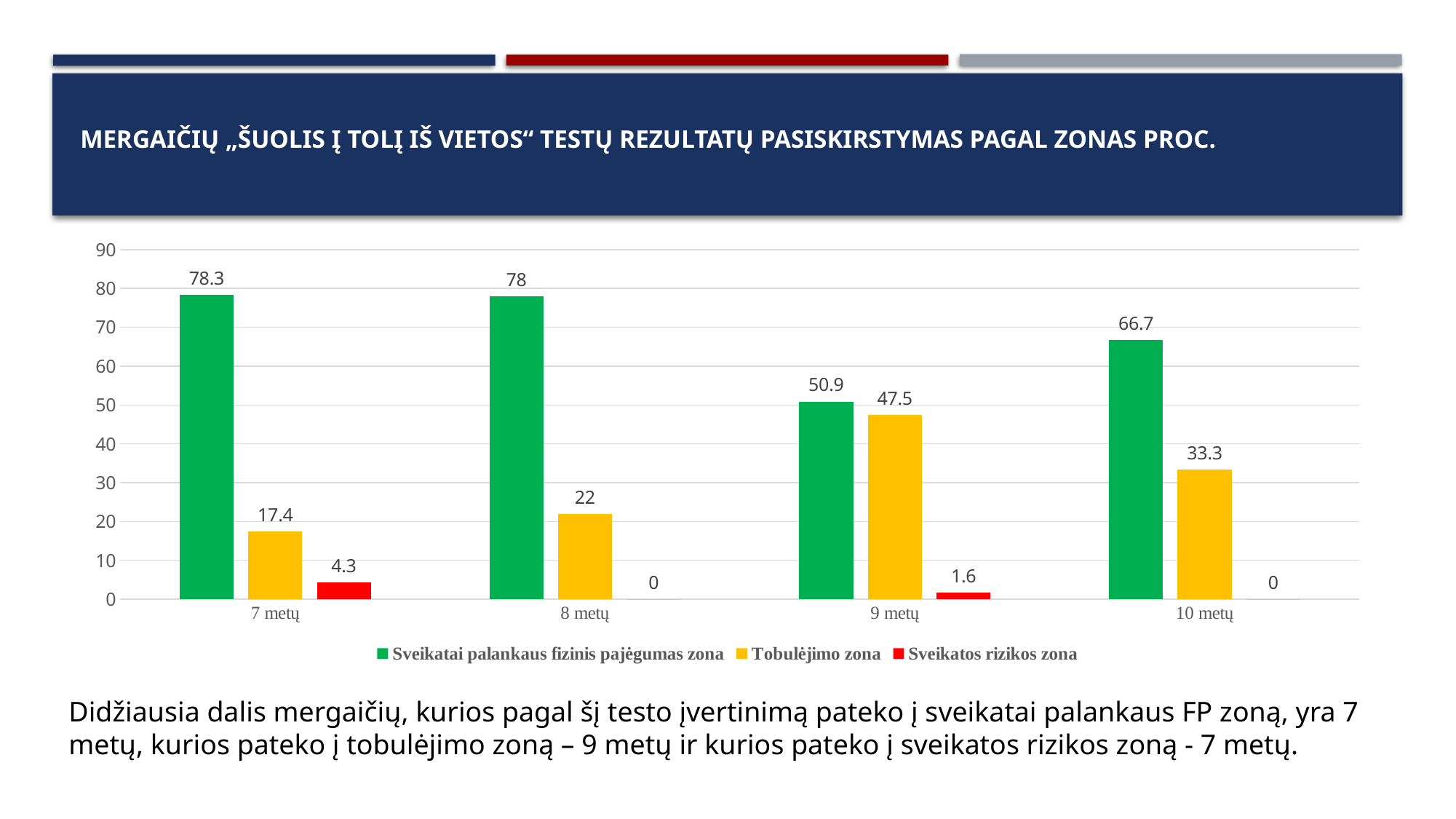
What kind of chart is shown on the slide? bar chart What is the value for 'Sveikatos rizikos zona' at 10 metų? 0 Which age group has the highest value for 'Sveikatai palankaus fizinis pajėgumas zona'? 7 metų Is the value for 'Tobulėjimo zona' at 8 metų greater or less than 30? less What colour represents 'Sveikatos rizikos zona' in the chart? red What is the value for 'Tobulėjimo zona' at 9 metų? 47.5 Which is larger at 9 metų: 'Sveikatai palankaus fizinis pajėgumas zona' or 'Tobulėjimo zona'? Sveikatai palankaus fizinis pajėgumas zona What is the difference between the 'Sveikatai palankaus fizinis pajėgumas zona' and 'Tobulėjimo zona' values at 10 metų? 33.4 Which age group has the lowest value for 'Tobulėjimo zona'? 7 metų How many series does the legend list? 3 How many age groups are shown on the x axis? 4 What is the value for 'Sveikatai palankaus fizinis pajėgumas zona' at 7 metų? 78.3